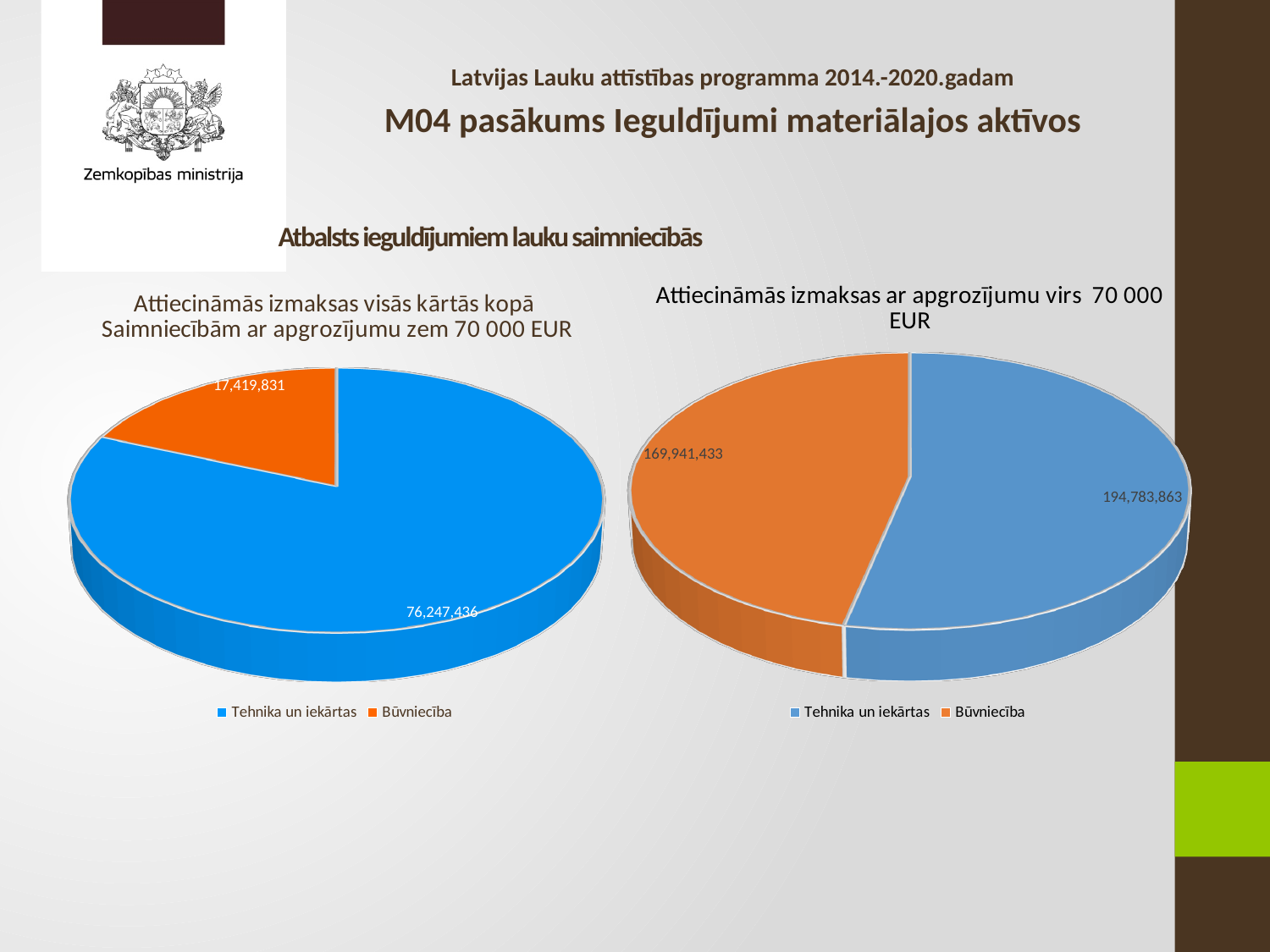
In the right pie chart (apgrozījumu virs 70 000 EUR), what is the difference between Tehnika un iekārtas and Būvniecība? 24,842,430 In the right pie chart (apgrozījumu virs 70 000 EUR), which category has the smallest slice? Būvniecība In the right pie chart (apgrozījumu virs 70 000 EUR), what is the value for Tehnika un iekārtas? 194,783,863 In the right pie chart (apgrozījumu virs 70 000 EUR), what is the value for Būvniecība? 169,941,433 How many slices does the left pie chart (Saimniecībām ar apgrozījumu zem 70 000 EUR) have? 2 In the left pie chart (Saimniecībām ar apgrozījumu zem 70 000 EUR), which category has the largest slice? Tehnika un iekārtas In the left pie chart (Saimniecībām ar apgrozījumu zem 70 000 EUR), what colour is the Būvniecība slice? Orange What type of chart is the right chart (apgrozījumu virs 70 000 EUR)? Pie chart In the left pie chart (Saimniecībām ar apgrozījumu zem 70 000 EUR), what is the value for Būvniecība? 17,419,831 In the left pie chart (Saimniecībām ar apgrozījumu zem 70 000 EUR), what is the value for Tehnika un iekārtas? 76,247,436 In the right pie chart (apgrozījumu virs 70 000 EUR), which is larger: Tehnika un iekārtas or Būvniecība? Tehnika un iekārtas In the left pie chart (Saimniecībām ar apgrozījumu zem 70 000 EUR), what is the difference between Tehnika un iekārtas and Būvniecība? 58,827,605